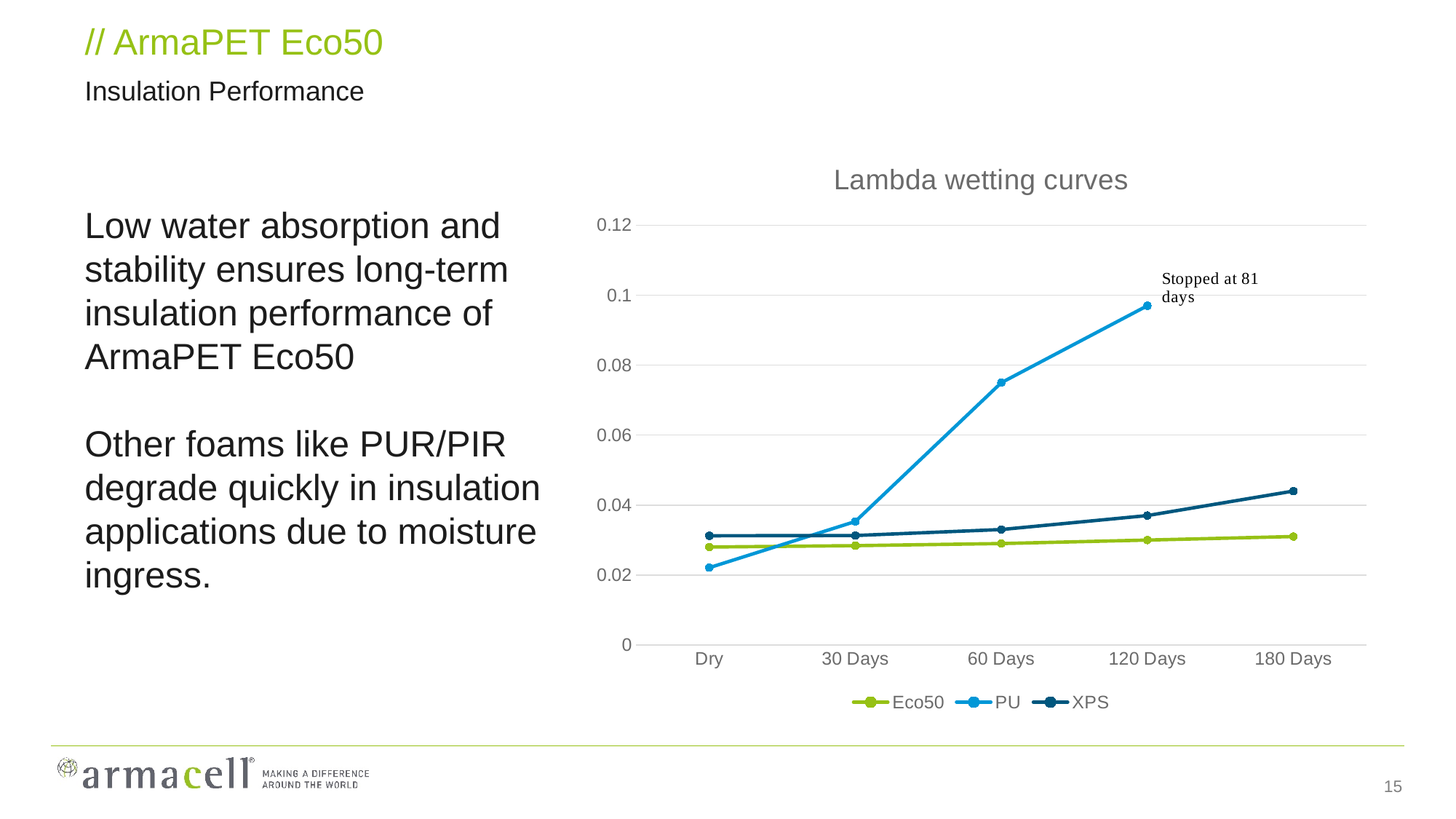
How many categories are shown on the x axis of the chart? 5 Which series has the lowest value at 180 Days? Eco50 Is the value for Eco50 at 180 Days greater or less than 0.04? less At Dry, which is larger, the value for XPS or the value for PU? XPS Does the PU series rise or fall from Dry to 120 Days? rise Which series has the lowest value at Dry? PU Is the value for PU at 120 Days greater or less than 0.08? greater Which series has the highest value at 120 Days? PU What is the title of the chart? Lambda wetting curves What kind of chart is shown on the slide? line chart Is the value for PU at 60 Days greater or less than 0.06? greater How many series does the chart legend list? 3